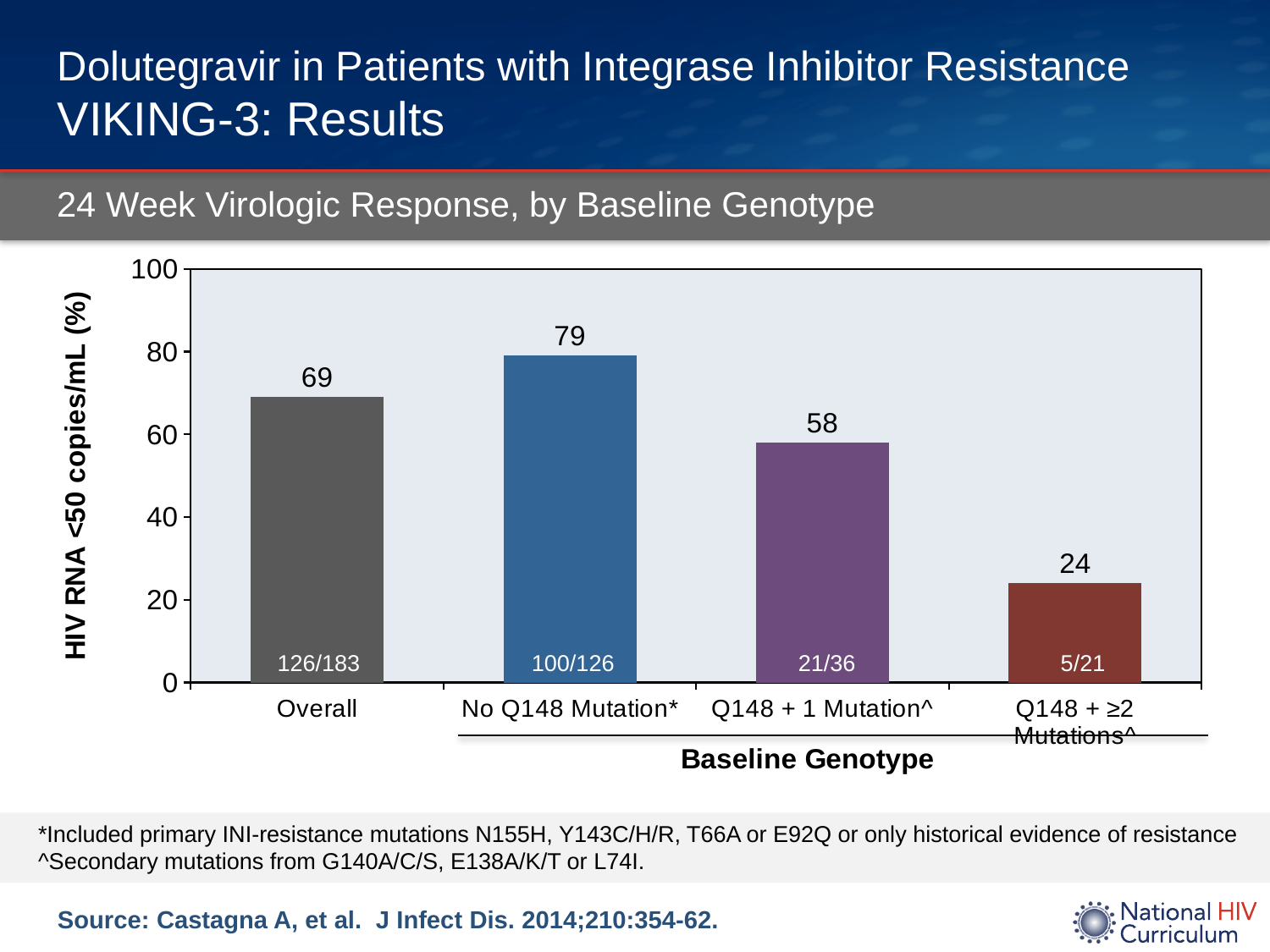
Which category has the highest value? No Q148 Mutation* What is the value for Overall? 69 Which category has the lowest value? Q148 + ≥2 Mutations^ What kind of chart is this? Bar chart What is the value for Q148 + ≥2 Mutations^? 24 What is the difference between the values for No Q148 Mutation* and Q148 + ≥2 Mutations^? 55 What is the value for Q148 + 1 Mutation^? 58 What is the y-axis label of the chart? HIV RNA <50 copies/mL (%) What fraction is printed inside the bar for Q148 + 1 Mutation^? 21/36 What is the value for No Q148 Mutation*? 79 Which is larger, the value for Overall or the value for Q148 + 1 Mutation^? Overall How many categories are shown on the x axis? 4